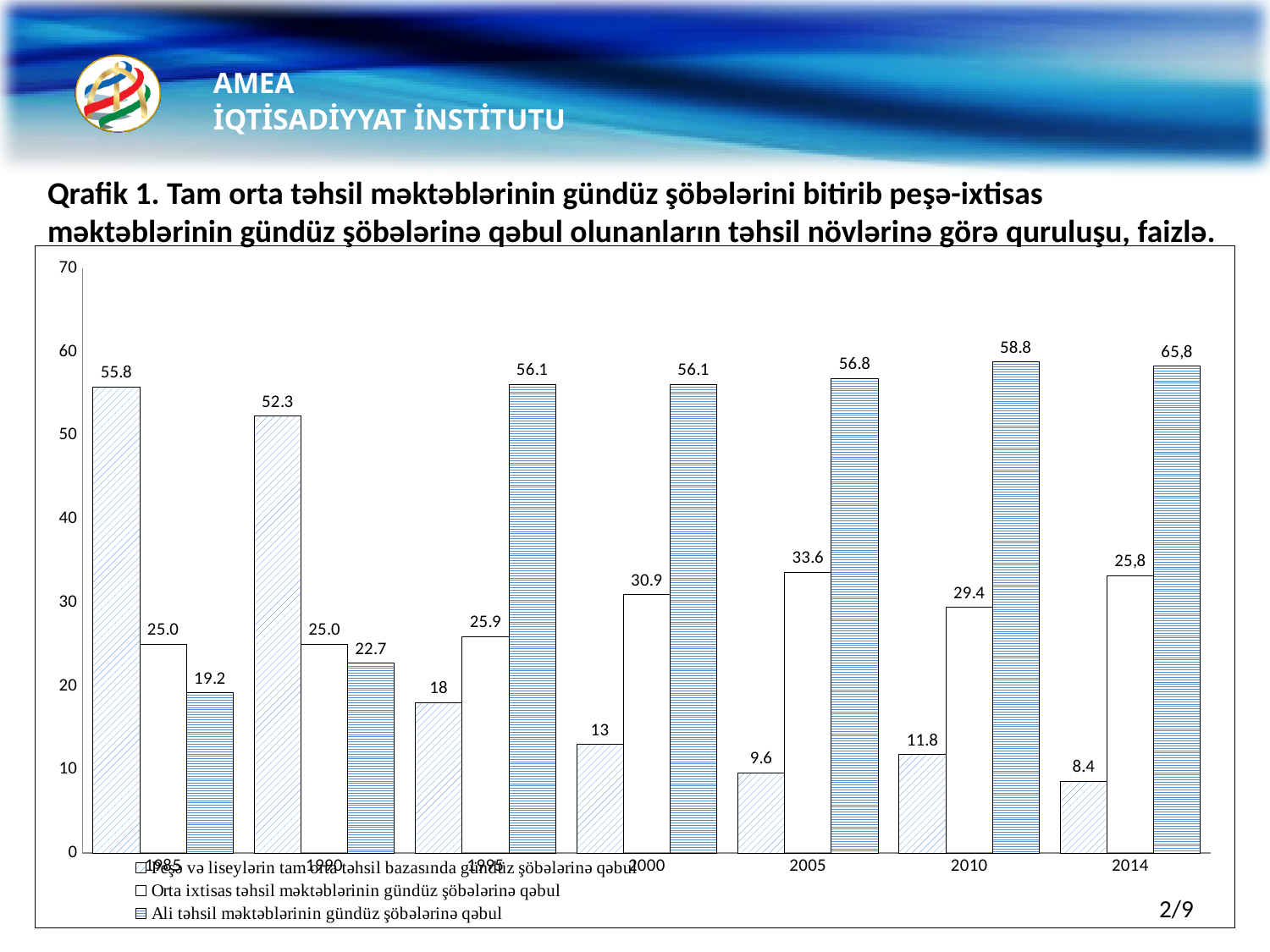
How many year categories are shown on the x axis? 7 What is the value for 'Peşə və liseylərin tam orta təhsil bazasında gündüz şöbələrinə qəbul' in 1985? 55.8 What is the value for 'Ali təhsil məktəblərinin gündüz şöbələrinə qəbul' in 2014? 65,8 What is the title of the chart? Qrafik 1. Tam orta təhsil məktəblərinin gündüz şöbələrini bitirib peşə-ixtisas məktəblərinin gündüz şöbələrinə qəbul olunanların təhsil növlərinə görə quruluşu, faizlə. How many series does the legend list? 3 Does the value for 'Peşə və liseylərin tam orta təhsil bazasında gündüz şöbələrinə qəbul' rise or fall from 1985 to 2014? fall What is the difference between the 'Ali təhsil' value in 2010 and the 'Peşə və liseylərin' value in 2010? 47.0 What type of chart is shown on the slide? bar chart Which is larger in 1990: the 'Orta ixtisas' value or the 'Ali təhsil' value? Orta ixtisas (25.0) In which year is the value for 'Peşə və liseylərin tam orta təhsil bazasında gündüz şöbələrinə qəbul' lowest? 2014 What is the value for 'Orta ixtisas təhsil məktəblərinin gündüz şöbələrinə qəbul' in 2005? 33.6